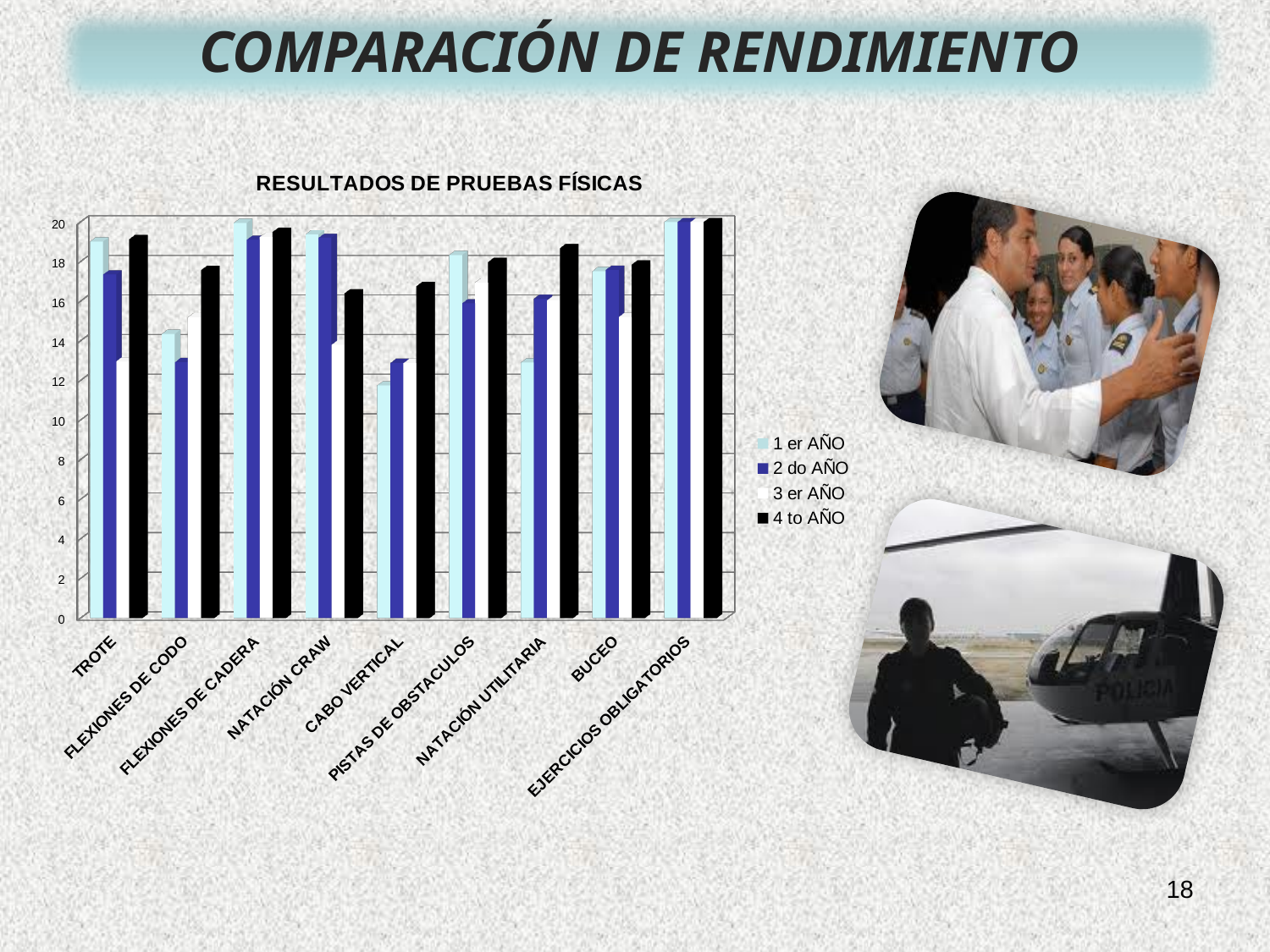
Which series is shown in black in the chart? 4 to AÑO In TROTE, which is larger: the value for 1 er AÑO or for 3 er AÑO? 1 er AÑO What kind of chart is shown on the slide? bar chart How many series does the chart's legend list? 4 What is the title of the chart? RESULTADOS DE PRUEBAS FÍSICAS In CABO VERTICAL, which is larger: the value for 4 to AÑO or for 1 er AÑO? 4 to AÑO Is the value for 3 er AÑO in TROTE greater or less than 16? less In FLEXIONES DE CODO, which series has the highest value? 4 to AÑO Is the value for 2 do AÑO in FLEXIONES DE CODO greater or less than 16? less Is the value for 1 er AÑO in CABO VERTICAL greater or less than 14? less How many categories (physical tests) are shown on the x axis of the chart? 9